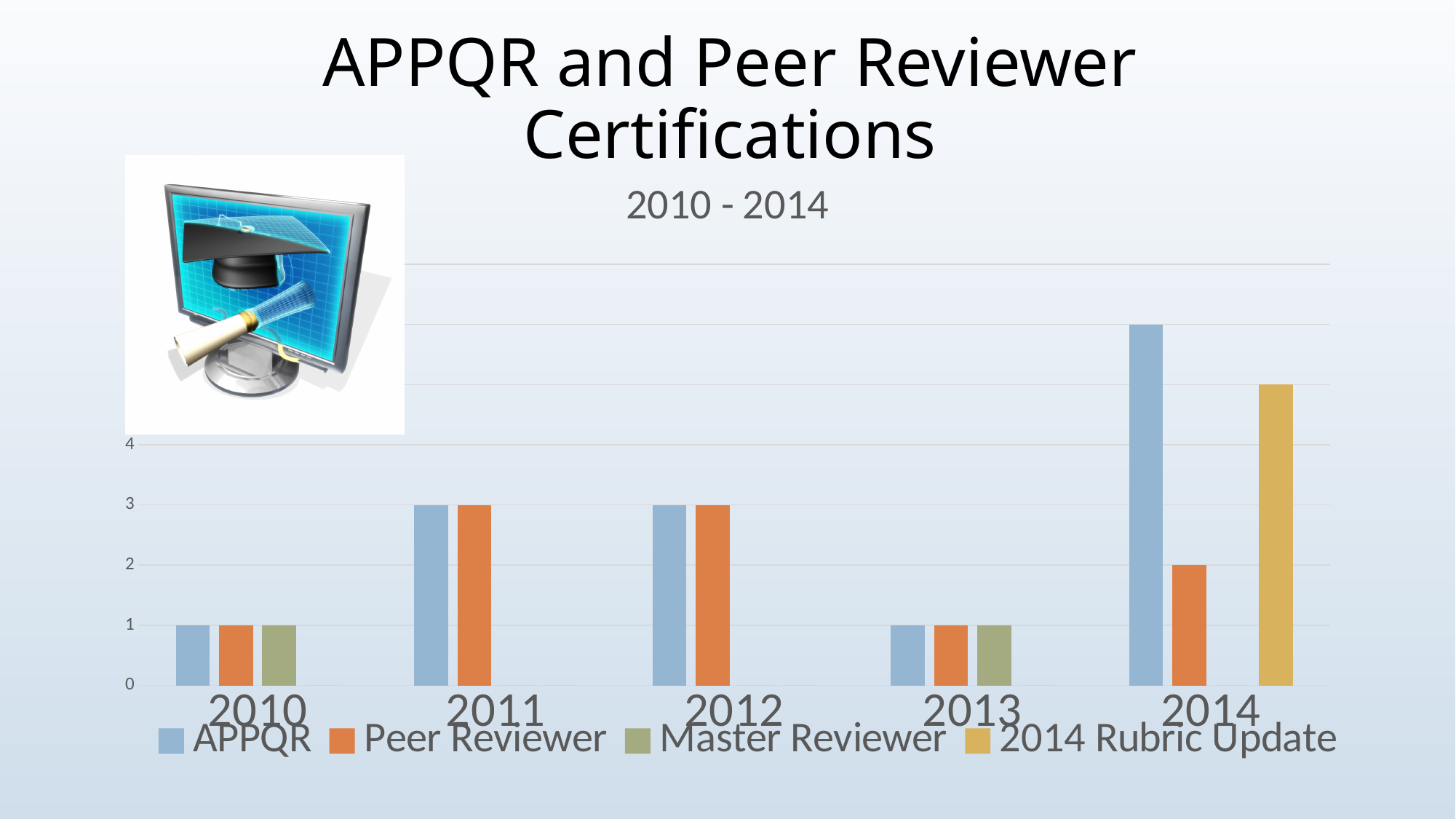
Is the value for APPQR in 2014 greater or less than 4? greater How many series does the legend list? 4 What is the difference between the APPQR value in 2011 and the APPQR value in 2010? 2 What type of chart is shown on the slide? bar chart How many years are shown on the x axis? 5 Which is larger in 2014, the APPQR bar or the Peer Reviewer bar? APPQR What is the value for Peer Reviewer in 2014? 2 Is the value for 2014 Rubric Update in 2014 greater or less than 4? greater What is the value for APPQR in 2011? 3 What is the value for Peer Reviewer in 2012? 3 In which year is the APPQR value highest? 2014 What is the value for Master Reviewer in 2013? 1